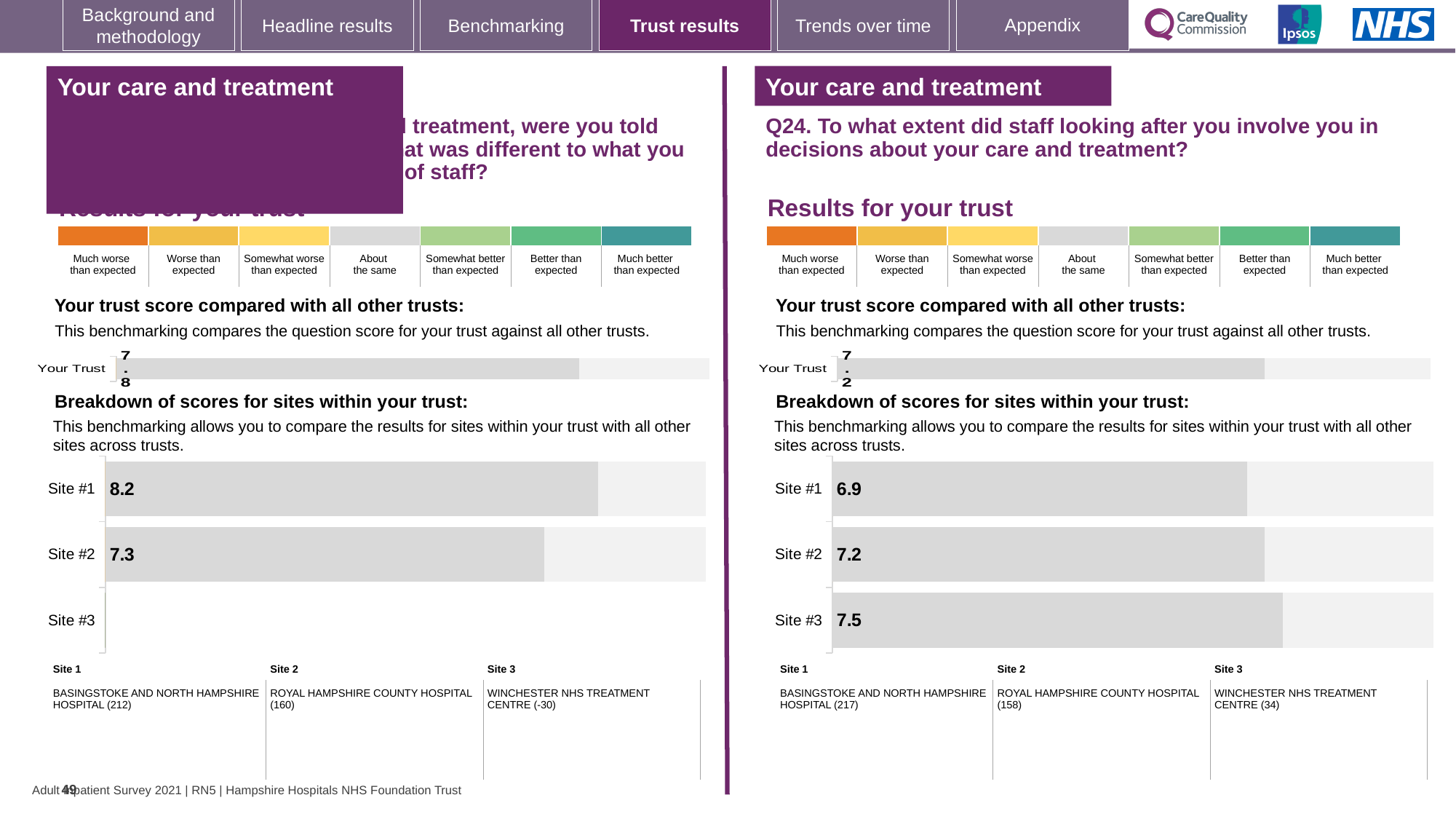
On the left-hand site breakdown chart, what is the score for Site #1? 8.2 On the right-hand (Q24) site breakdown chart, what is the score for Site #3? 7.5 On the right-hand (Q24) site breakdown chart, which site has the highest score? Site #3 On the right-hand (Q24) site breakdown chart, what is the score for Site #1? 6.9 On the right-hand (Q24) site breakdown chart, what is the difference between the scores for Site #3 and Site #1? 0.6 On the right-hand (Q24) 'Your trust score compared with all other trusts' chart, what is the score shown for Your Trust? 7.2 On the right-hand (Q24) site breakdown chart, which site has the lowest score? Site #1 On the left-hand site breakdown chart, what is the difference between the scores for Site #1 and Site #2? 0.9 On the left-hand 'Your trust score compared with all other trusts' chart, what is the score shown for Your Trust? 7.8 What type of chart is used for the site breakdown on the right-hand (Q24) side of the slide? Bar chart On the right-hand (Q24) site breakdown chart, which has the larger score, Site #2 or Site #3? Site #3 On the left-hand site breakdown chart, what is the score for Site #2? 7.3